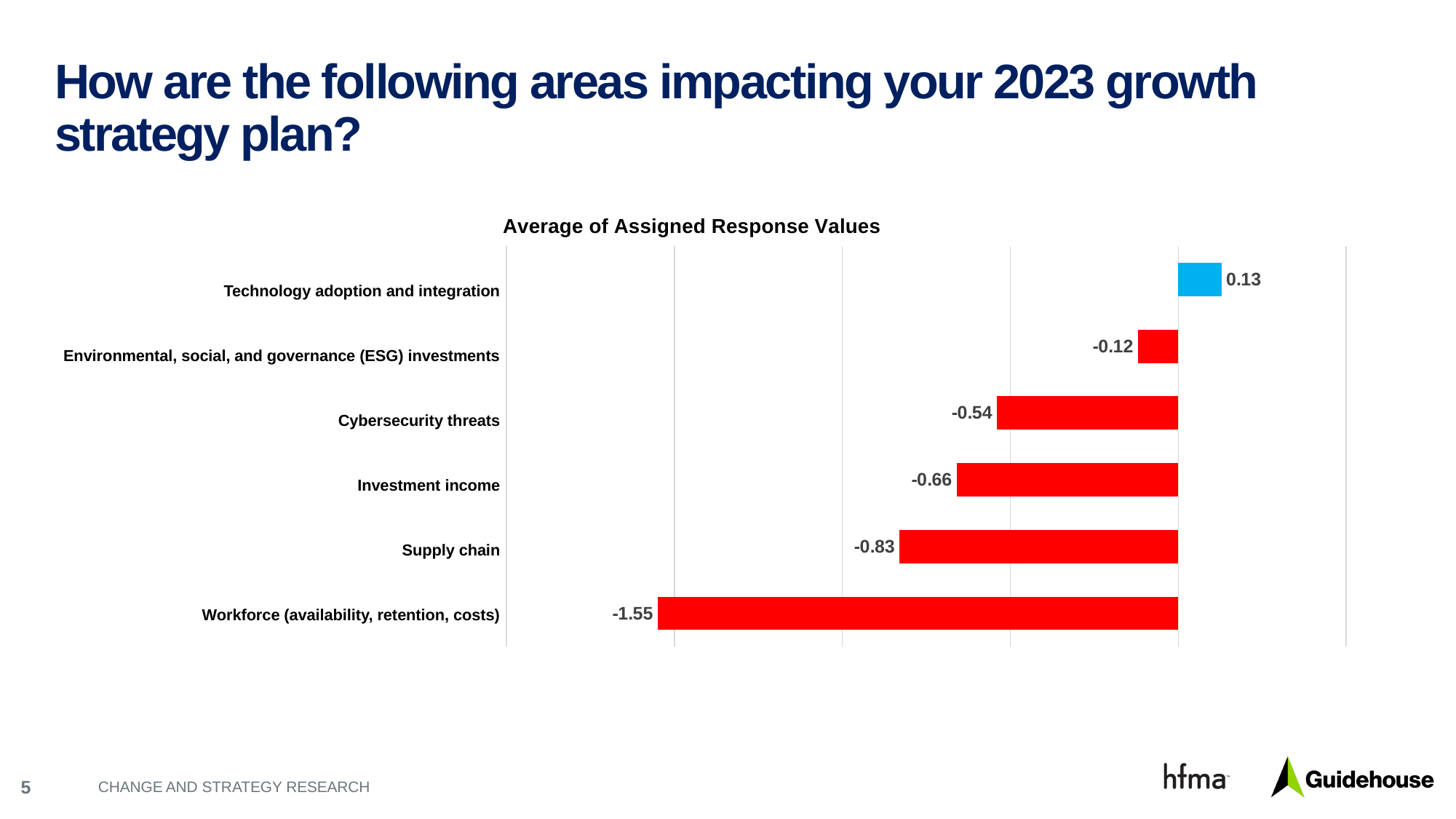
What is the difference between the values for Investment income and Cybersecurity threats? 0.12 Which has a larger value, Environmental, social, and governance (ESG) investments or Supply chain? Environmental, social, and governance (ESG) investments What is the value shown for Supply chain? -0.83 Which area has the highest average assigned response value? Technology adoption and integration What is the title of the chart? Average of Assigned Response Values What kind of chart is shown on the slide? Bar chart What is the value shown for Cybersecurity threats? -0.54 How many bars in the chart are coloured blue rather than red? 1 What is the average assigned response value for Technology adoption and integration? 0.13 How many areas are plotted in the chart? 6 What is the average assigned response value for Workforce (availability, retention, costs)? -1.55 Which area has the lowest average assigned response value? Workforce (availability, retention, costs)